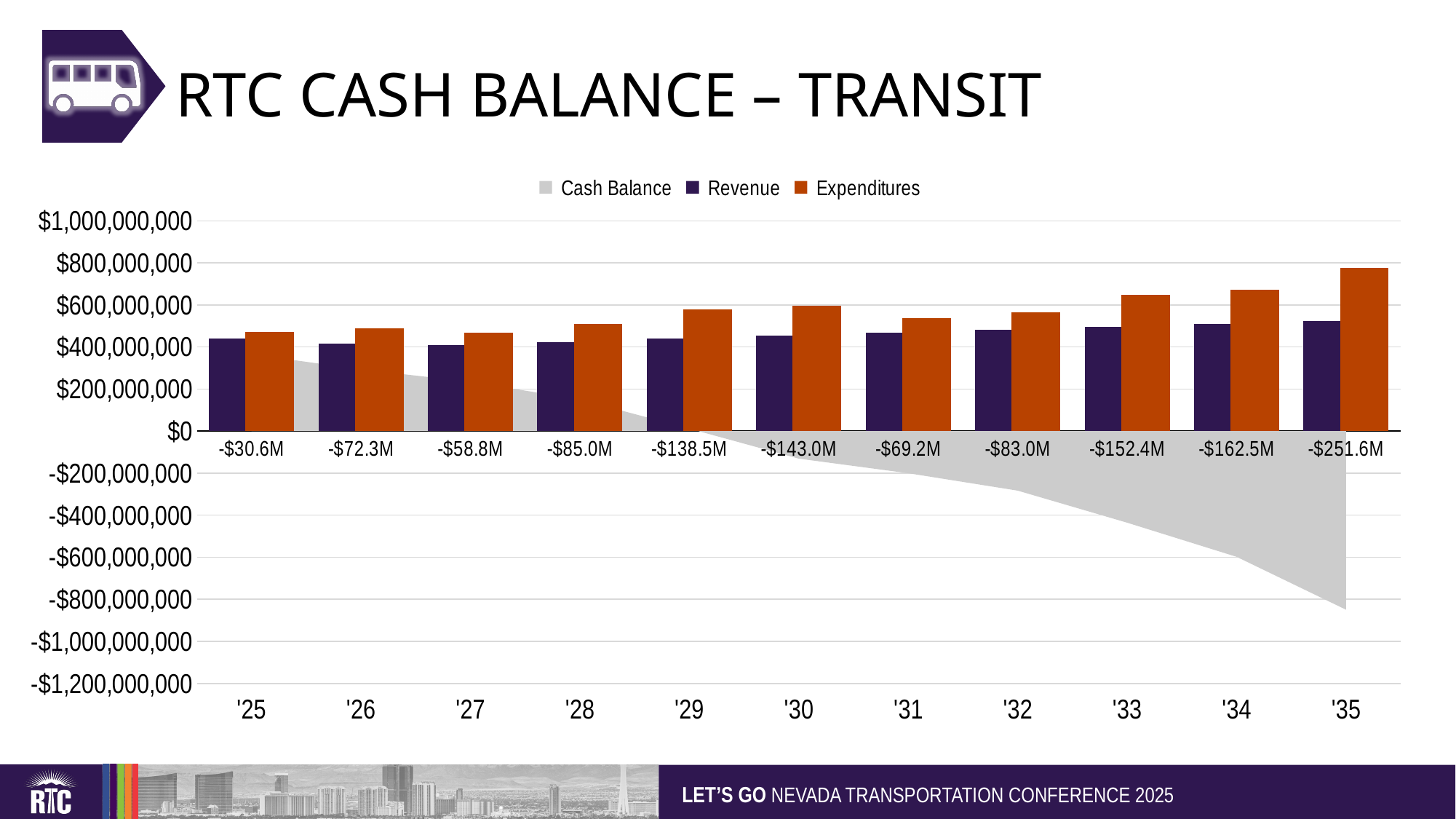
How many years are shown along the x axis? 11 In '35, which is larger, Revenue or Expenditures? Expenditures Do the Expenditures bars generally rise or fall from '25 to '35? rise What value is labelled below the axis for '35? -$251.6M Is the Expenditures value for '35 greater or less than $600,000,000? greater What is the difference between the labelled values for '34 and '35? $89.1M What colour represents Expenditures in the legend? orange What kind of chart is used to plot the Revenue and Expenditures series? bar chart Which year has the most negative value labelled below the axis? '35 How many series does the legend list? 3 Which year has the smallest negative value labelled below the axis? '25 What value is labelled below the axis for '29? -$138.5M